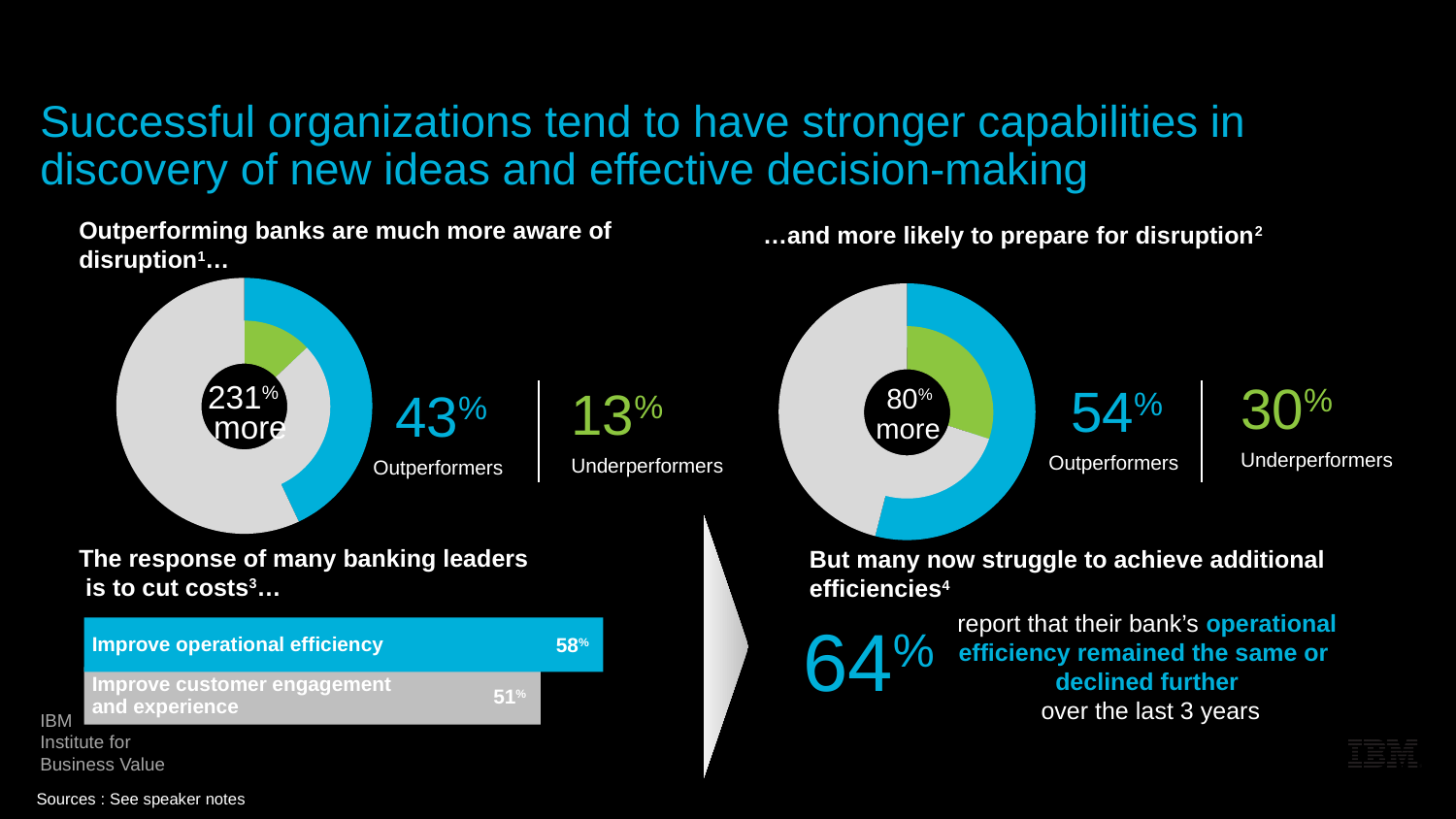
In the chart titled 'The response of many banking leaders is to cut costs', what is the value for 'Improve customer engagement and experience'? 51% In the chart titled '...and more likely to prepare for disruption', what is the value for Outperformers? 54% In the chart titled 'Outperforming banks are much more aware of disruption', what is the value for Underperformers? 13% In the chart titled '...and more likely to prepare for disruption', what is the difference between the Outperformers and Underperformers values? 24% In the chart titled 'The response of many banking leaders is to cut costs', what is the difference between the two bars? 7% In the chart titled 'Outperforming banks are much more aware of disruption', what is the difference between the Outperformers and Underperformers values? 30% In the chart titled 'The response of many banking leaders is to cut costs', what is the value for 'Improve operational efficiency'? 58% What text is shown in the centre of the donut chart titled 'Outperforming banks are much more aware of disruption'? 231% more In the chart titled 'The response of many banking leaders is to cut costs', which category has the highest value? Improve operational efficiency What kind of chart is shown under 'The response of many banking leaders is to cut costs'? Bar chart In the chart titled 'Outperforming banks are much more aware of disruption', what is the value for Outperformers? 43% In the chart titled '...and more likely to prepare for disruption', what is the value for Underperformers? 30%